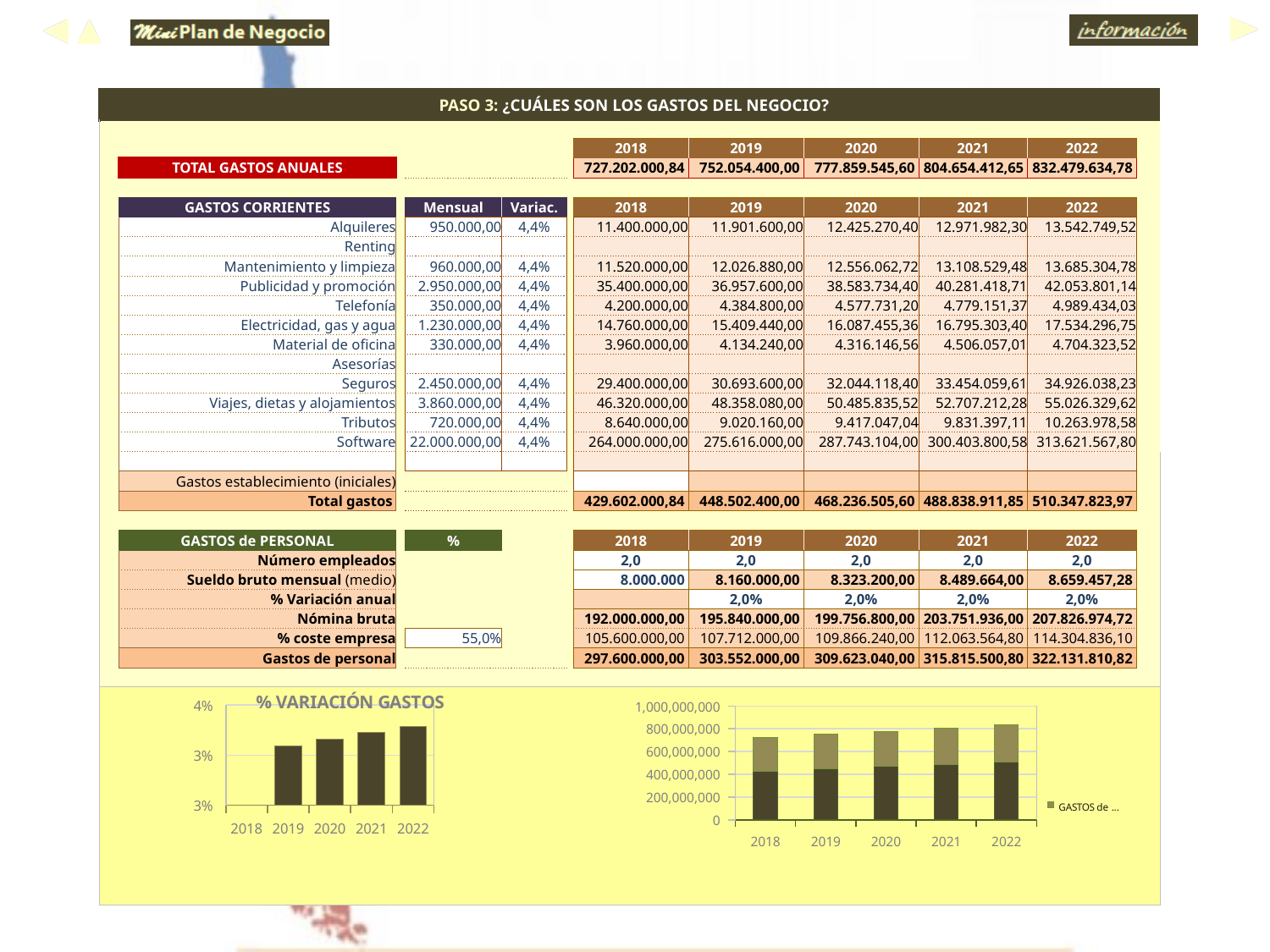
How many years are shown on the x axis of the chart on the right of the slide? 5 In the chart on the right of the slide, which year has the shortest stacked bar? 2018 In the chart on the right of the slide, do the stacked bars rise or fall from 2018 to 2022? rise What is the title of the chart on the left of the slide? % VARIACIÓN GASTOS In the '% VARIACIÓN GASTOS' chart, which year has the tallest bar? 2022 What kind of chart is the chart on the right of the slide? stacked bar chart In the '% VARIACIÓN GASTOS' chart, do the bars rise or fall from 2019 to 2022? rise In the chart on the right of the slide, is the total height of the 2018 bar greater or less than 800,000,000? less What kind of chart is the '% VARIACIÓN GASTOS' chart? bar chart In the '% VARIACIÓN GASTOS' chart, is the bar for 2021 taller or shorter than the bar for 2019? taller How many years are shown on the x axis of the '% VARIACIÓN GASTOS' chart? 5